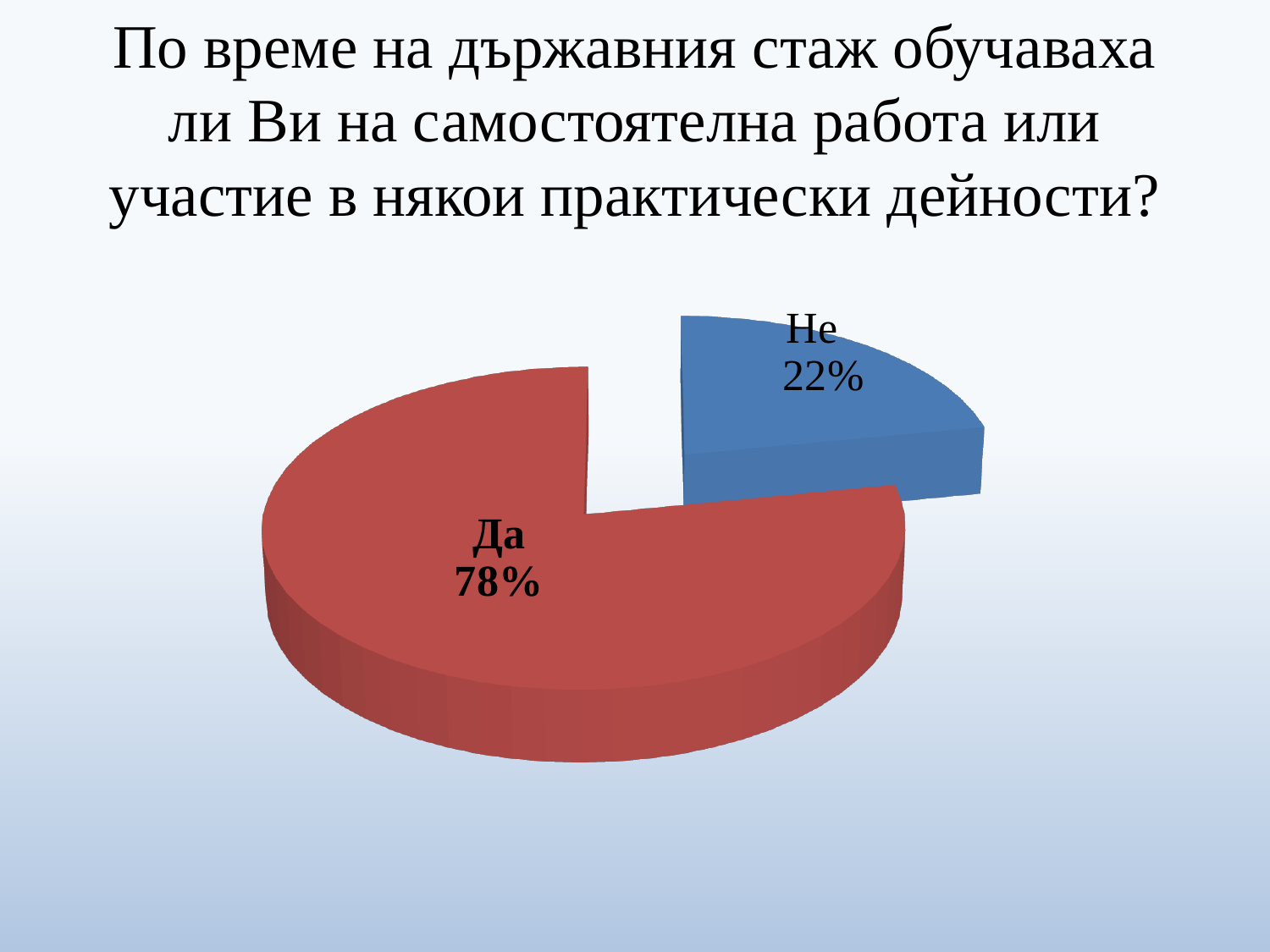
Which slice is the smallest? Не How many slices does the pie chart have? 2 What percentage is shown for the "Не" slice? 22% Which is larger, the "Да" slice or the "Не" slice? Да What kind of chart is shown on the slide? pie chart Which slice is the largest? Да What colour is the "Да" slice? red What colour is the "Не" slice? blue What percentage is shown for the "Да" slice? 78% What share of the pie does the "Не" slice represent? 22% What is the difference in percentage points between the "Да" and "Не" slices? 56